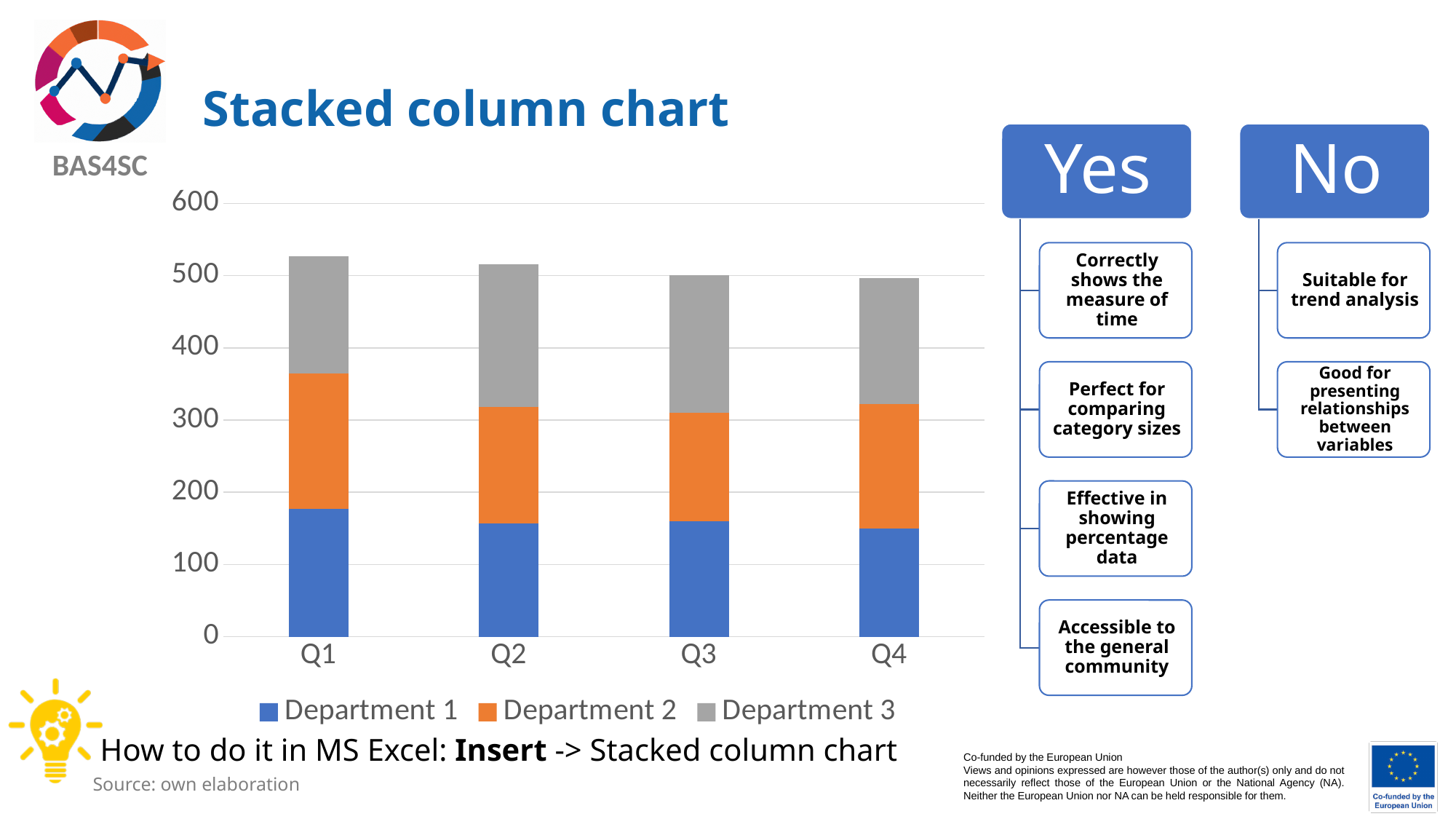
Which colour represents Department 2 in the chart's legend? orange Is the Department 1 value for Q4 greater or less than 100? greater Which quarter has the largest Department 1 segment? Q1 Is the total stacked value for Q2 greater or less than 500? greater What kind of chart is shown on the slide? stacked bar chart How many series does the chart's legend list? 3 Is the total stacked value for Q1 greater or less than 500? greater Do the total stacked bar heights generally rise or fall from Q1 to Q4? fall How many quarters (categories) are shown on the x axis of the chart? 4 Is the total stacked bar for Q1 larger or smaller than the total for Q4? larger Which quarter has the tallest stacked bar overall? Q1